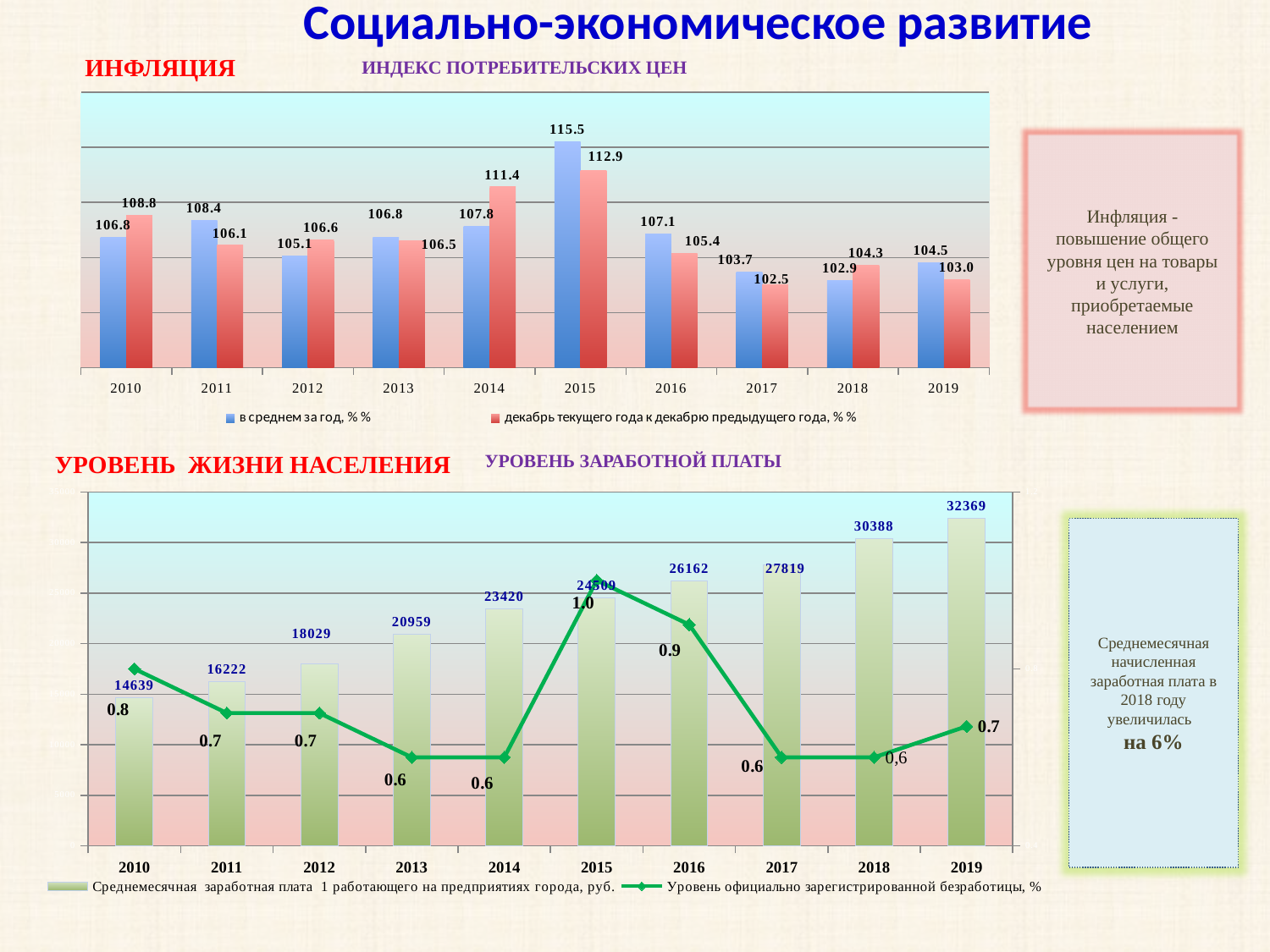
In the chart titled ИНДЕКС ПОТРЕБИТЕЛЬСКИХ ЦЕН, what is the value of 'в среднем за год, %' for 2015? 115.5 In the chart titled УРОВЕНЬ ЗАРАБОТНОЙ ПЛАТЫ, what is the average monthly wage (Среднемесячная заработная плата) for 2019? 32369 What kind of chart is the chart titled ИНДЕКС ПОТРЕБИТЕЛЬСКИХ ЦЕН? Bar chart In the chart titled ИНДЕКС ПОТРЕБИТЕЛЬСКИХ ЦЕН, what is the difference between the two series' values for 2015? 2.6 In the chart titled ИНДЕКС ПОТРЕБИТЕЛЬСКИХ ЦЕН, how many series does the legend list? 2 In the chart titled УРОВЕНЬ ЗАРАБОТНОЙ ПЛАТЫ, what is the registered unemployment rate (Уровень официально зарегистрированной безработицы, %) for 2015? 1.0 In the chart titled ИНДЕКС ПОТРЕБИТЕЛЬСКИХ ЦЕН, which year has the lowest value for 'декабрь текущего года к декабрю предыдущего года, %'? 2017 In the chart titled ИНДЕКС ПОТРЕБИТЕЛЬСКИХ ЦЕН, which year has the highest value for 'в среднем за год, %'? 2015 In the chart titled УРОВЕНЬ ЗАРАБОТНОЙ ПЛАТЫ, what is the difference in average monthly wage between 2019 and 2018? 1981 In the chart titled УРОВЕНЬ ЗАРАБОТНОЙ ПЛАТЫ, does the average monthly wage rise or fall from 2010 to 2019? Rises In the chart titled УРОВЕНЬ ЗАРАБОТНОЙ ПЛАТЫ, how many years are shown on the x axis? 10 In the chart titled ИНДЕКС ПОТРЕБИТЕЛЬСКИХ ЦЕН, what is the value of 'декабрь текущего года к декабрю предыдущего года, %' for 2014? 111.4